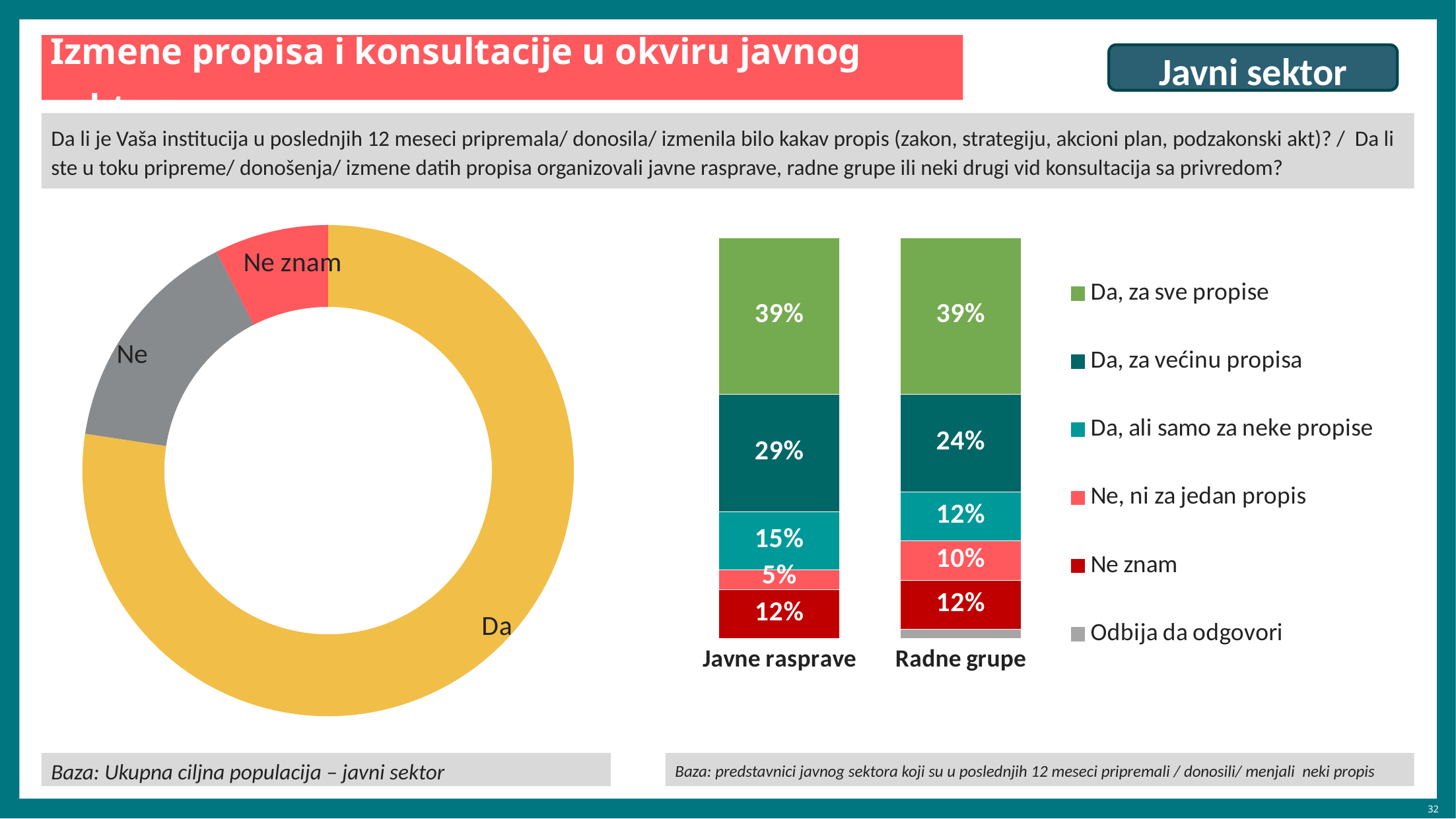
In the stacked bar chart on the right, what is the difference between 'Da, za većinu propisa' for Javne rasprave and for Radne grupe? 5% What kind of chart is the chart on the right of the slide? Stacked bar chart How many series does the legend of the stacked bar chart on the right list? 6 In the stacked bar chart on the right, what is the value for 'Da, za većinu propisa' in the Javne rasprave bar? 29% In the stacked bar chart on the right, which is larger: 'Da, ali samo za neke propise' for Javne rasprave or for Radne grupe? Javne rasprave In the donut chart on the left, which category has the smallest share? Ne znam How many categories does the donut chart on the left show? 3 In the donut chart on the left, which is larger: the share for Ne or the share for Ne znam? Ne In the stacked bar chart on the right, what is the value for 'Ne, ni za jedan propis' in the Radne grupe bar? 10% In the donut chart on the left, which category has the largest share? Da In the stacked bar chart on the right, what is the total of the labelled segments in the Javne rasprave bar? 100% What kind of chart is the chart on the left of the slide? Donut (pie) chart